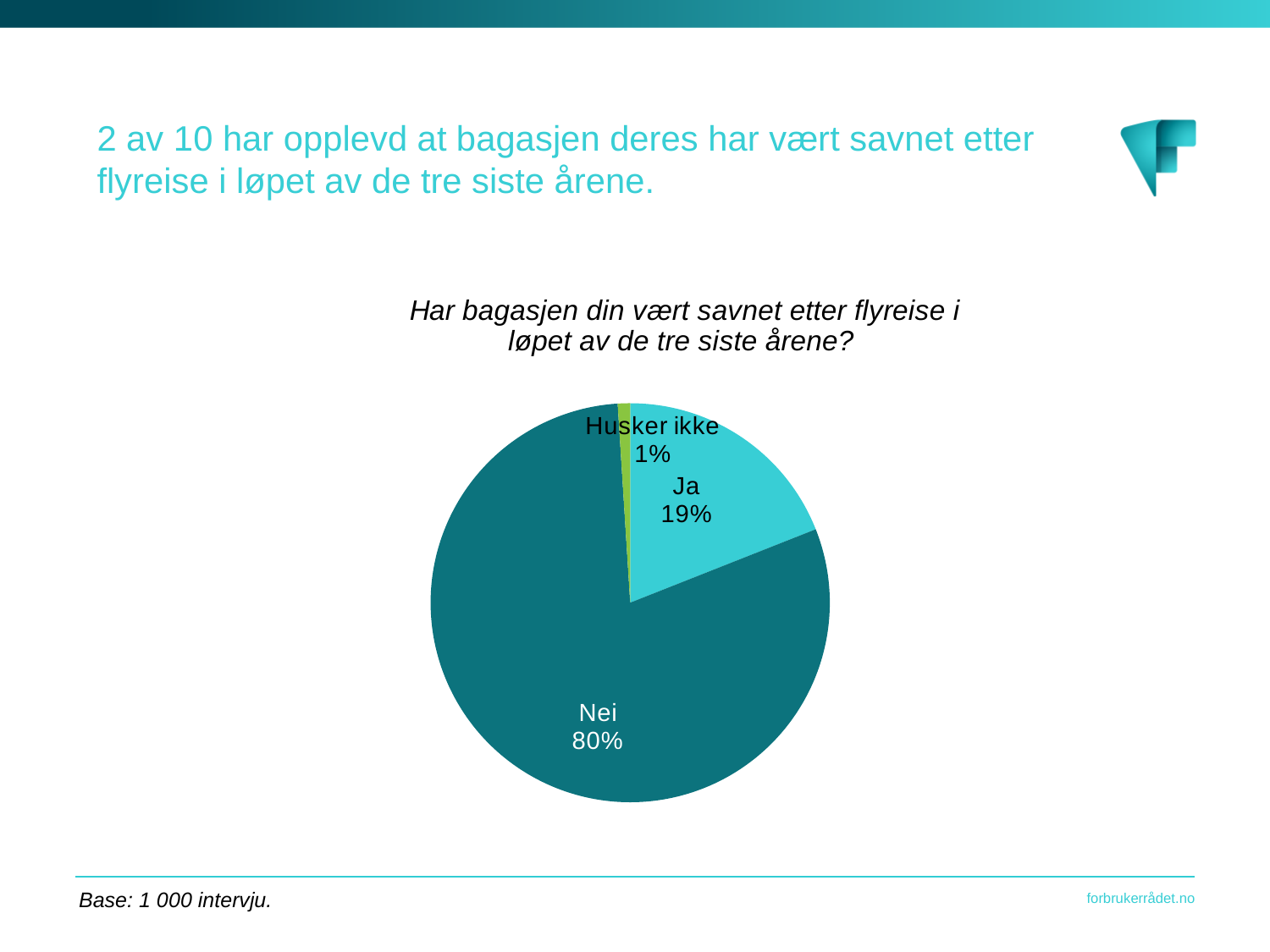
What share of the pie does the "Nei" slice represent? 80% What share of the pie does the "Husker ikke" slice represent? 1% What is the title of the chart? Har bagasjen din vært savnet etter flyreise i løpet av de tre siste årene? Which slice is larger, "Ja" or "Husker ikke"? Ja What is the difference in percentage points between the "Ja" and "Husker ikke" slices? 18 What is the difference in percentage points between the "Nei" and "Ja" slices? 61 Which category has the smallest slice of the pie? Husker ikke Which category has the largest slice of the pie? Nei What share of the pie does the "Ja" slice represent? 19% How many slices does the pie chart have? 3 What is the base (number of interviews) stated on the slide? 1 000 intervju What kind of chart is shown on the slide? Pie chart